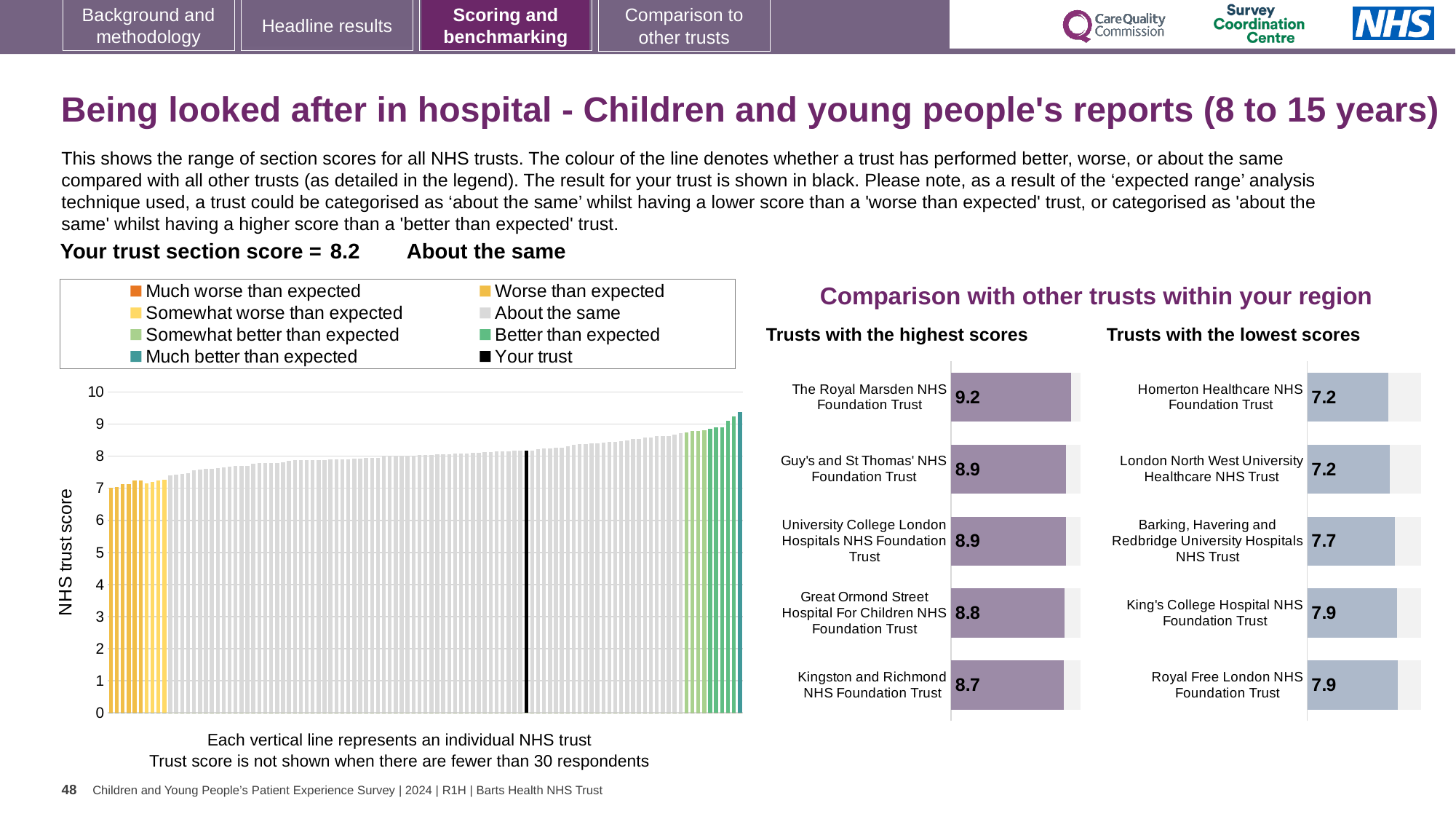
How many trusts are listed in the 'Trusts with the lowest scores' chart? 5 In the main 'NHS trust score' chart on the left, do the trust scores rise or fall from left to right? rise In the 'Trusts with the highest scores' chart, which trust has the lowest score? Kingston and Richmond NHS Foundation Trust In the 'Trusts with the highest scores' chart, which trust has the highest score? The Royal Marsden NHS Foundation Trust In the 'Trusts with the lowest scores' chart, what is the score for Barking, Havering and Redbridge University Hospitals NHS Trust? 7.7 In the 'Trusts with the highest scores' chart, what is the score for The Royal Marsden NHS Foundation Trust? 9.2 In the main 'NHS trust score' chart on the left, is the value of the lowest trust greater or less than 6? greater In the 'Trusts with the highest scores' chart, what is the difference between the scores of The Royal Marsden NHS Foundation Trust and Kingston and Richmond NHS Foundation Trust? 0.5 What kind of chart is the main 'NHS trust score' chart on the left? bar chart In the 'Trusts with the lowest scores' chart, which has the larger score: Barking, Havering and Redbridge University Hospitals NHS Trust or King's College Hospital NHS Foundation Trust? King's College Hospital NHS Foundation Trust In the main 'NHS trust score' chart on the left, what is the section score for your trust (the black line)? 8.2 How many entries does the legend above the main 'NHS trust score' chart list? 8